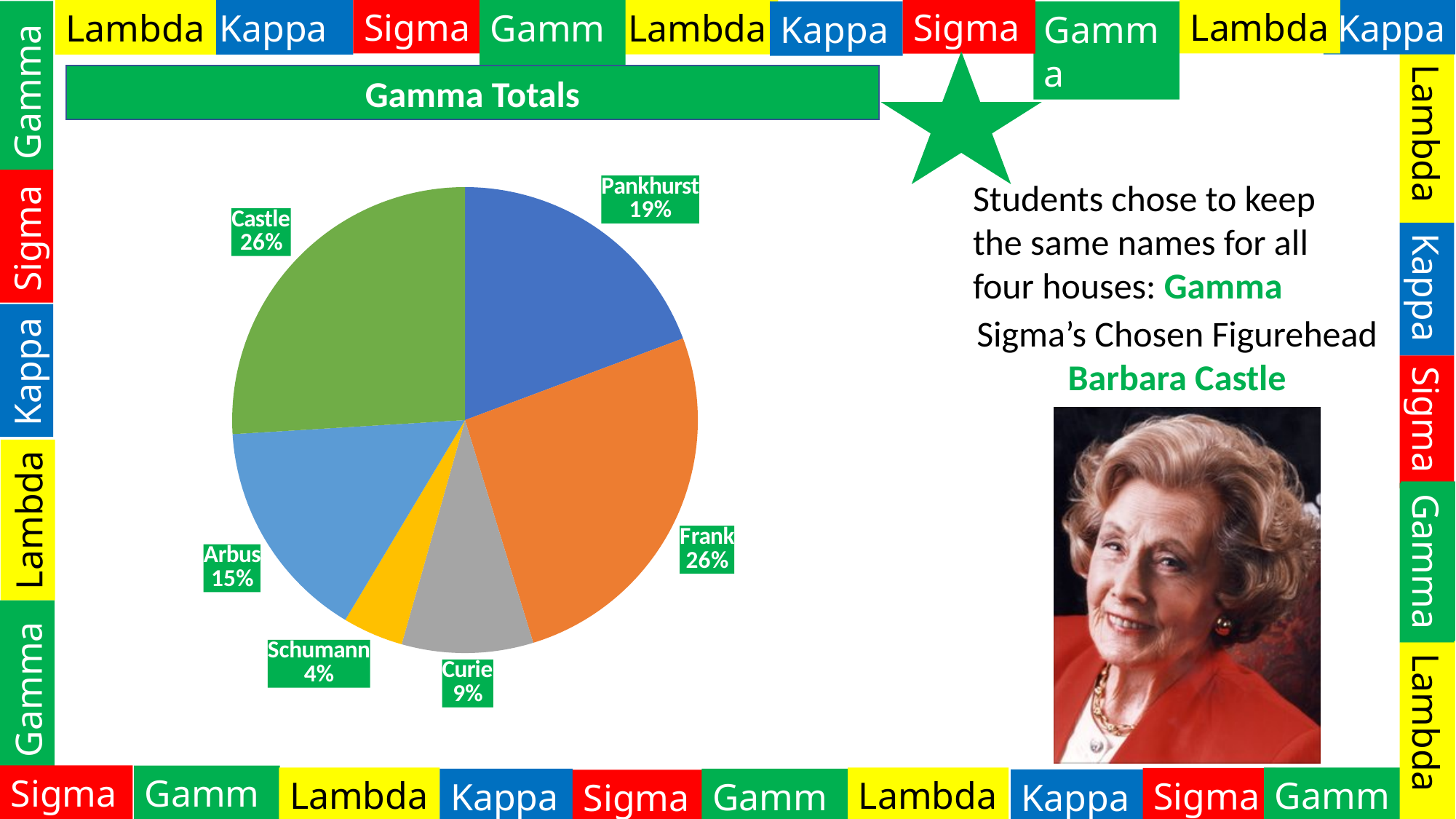
How many slices does the pie chart have? 6 What kind of chart is shown on the slide? pie chart What is the difference in percentage points between Curie and Schumann? 5 What is the value shown for Curie? 9% What is the value shown for Arbus? 15% What share of the pie does Castle represent? 26% What is the value shown for Frank? 26% What is the difference in percentage points between Pankhurst and Arbus? 4 Which is larger, the slice for Pankhurst or the slice for Curie? Pankhurst Which category has the smallest slice of the pie? Schumann What percentage of the pie does Pankhurst account for? 19% What is the title of the chart? Gamma Totals